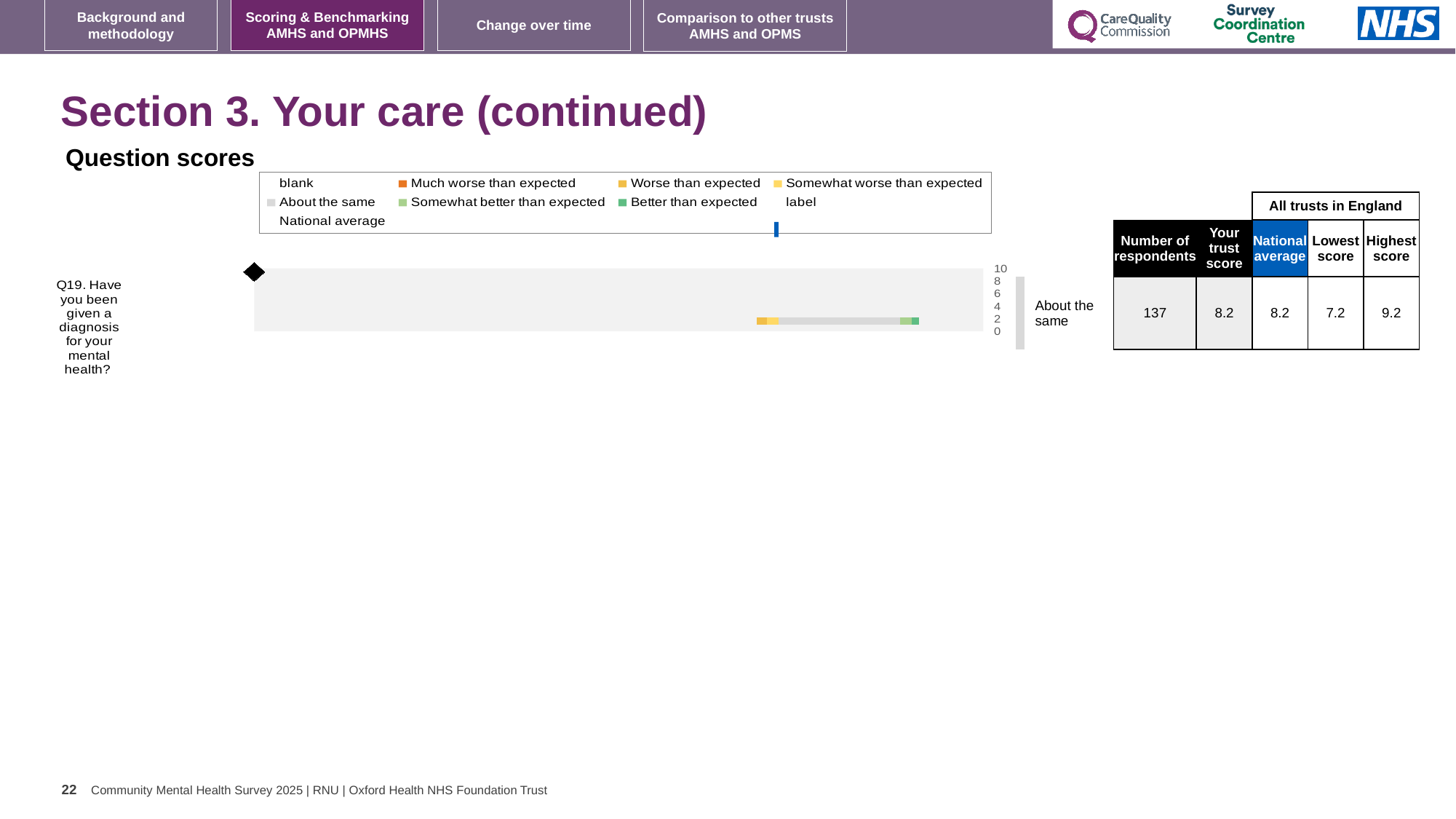
What is the difference between the highest score and the lowest score for Q19? 2.0 Is your trust score for Q19 higher than, lower than, or the same as the national average? the same What is the benchmark category shown for Q19? About the same What is the national average for Q19? 8.2 What kind of chart is used to show the question scores on this slide? bar chart Is your trust score for Q19 greater or less than 6? greater What is the number of respondents for Q19? 137 What is the lowest score among all trusts in England for Q19? 7.2 What is the highest score among all trusts in England for Q19? 9.2 Which question is shown in the question scores chart? Q19. Have you been given a diagnosis for your mental health? How many questions are plotted in the question scores chart? 1 What is your trust score for Q19? 8.2